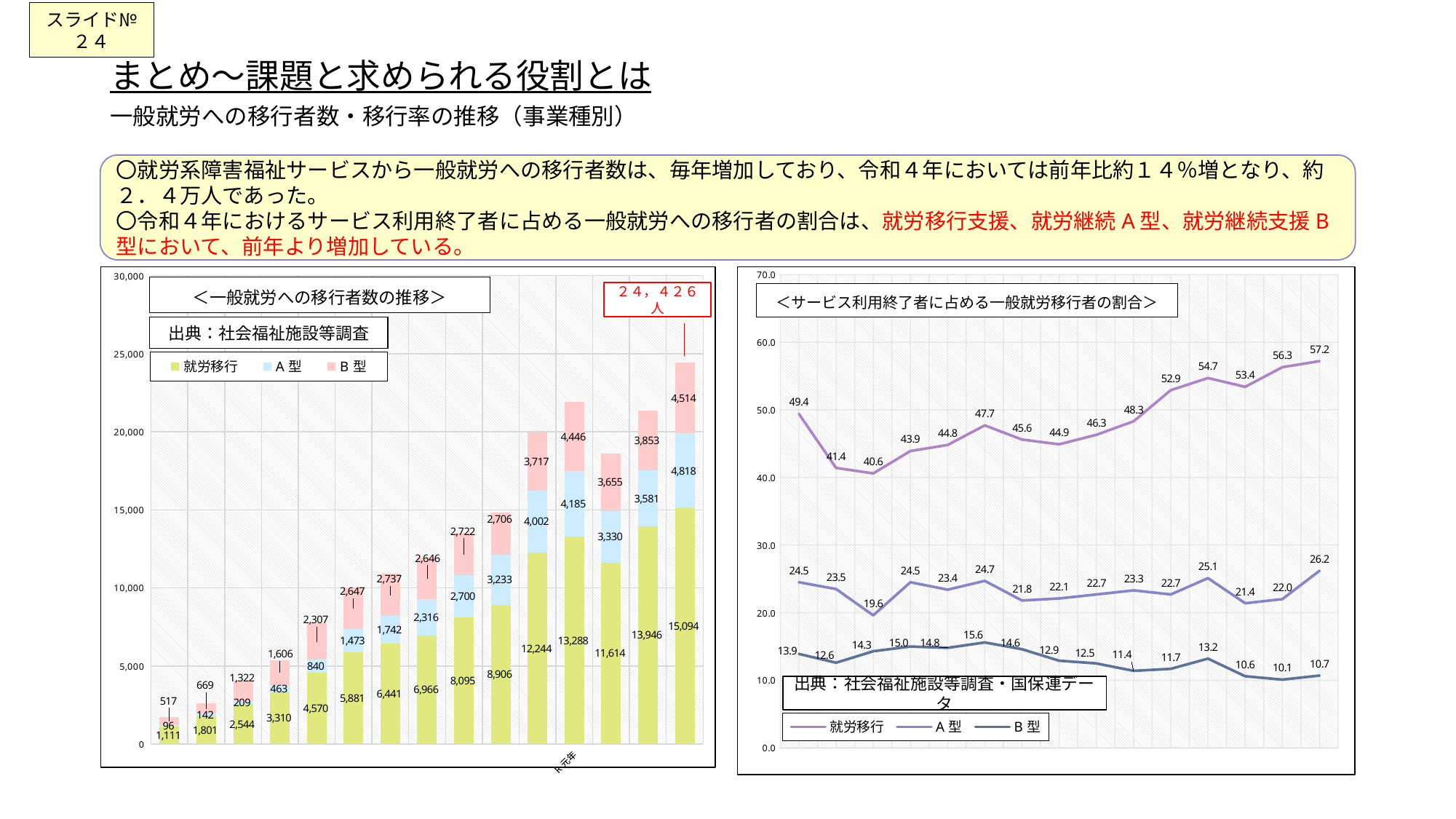
What kind of chart is the right chart titled ＜サービス利用終了者に占める一般就労移行者の割合＞? Line chart In the left chart ＜一般就労への移行者数の推移＞, do the 就労移行 values generally rise or fall from left to right? Rise In the right chart ＜サービス利用終了者に占める一般就労移行者の割合＞, what is the lowest value on the B型 line? 10.1 What kind of chart is the left chart titled ＜一般就労への移行者数の推移＞? Stacked bar chart In the left chart ＜一般就労への移行者数の推移＞, what is the B型 value for the leftmost bar? 517 In the left chart ＜一般就労への移行者数の推移＞, how many series does the legend list? 3 In the right chart ＜サービス利用終了者に占める一般就労移行者の割合＞, what is the highest value on the 就労移行 line? 57.2 In the right chart ＜サービス利用終了者に占める一般就労移行者の割合＞, what is the difference between the rightmost 就労移行 value (57.2) and the rightmost A型 value (26.2)? 31.0 In the left chart ＜一般就労への移行者数の推移＞, what is the 就労移行 value for the rightmost bar? 15,094 In the right chart ＜サービス利用終了者に占める一般就労移行者の割合＞, which series does the legend list: 就労移行, A型 and what else? B型 In the left chart ＜一般就労への移行者数の推移＞, how many stacked bars are plotted? 15 In the left chart ＜一般就労への移行者数の推移＞, what is the total of the rightmost stacked bar as annotated on the slide? 24,426人